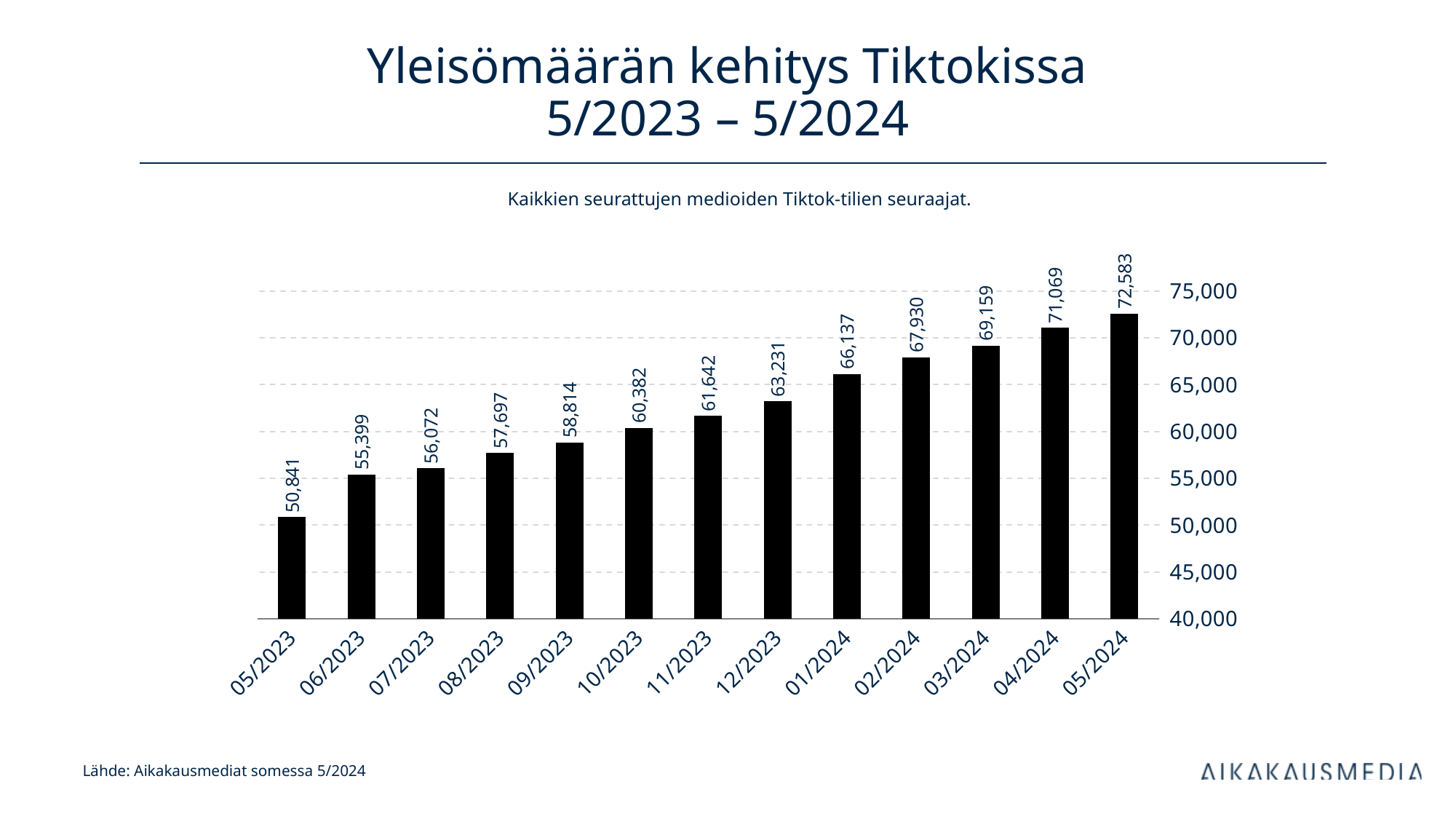
Do the values rise or fall from 05/2023 to 05/2024? rise What is the value for 05/2023? 50,841 Which is larger, the value for 09/2023 or the value for 10/2023? 10/2023 What kind of chart is shown on the slide? bar chart Is the value for 11/2023 greater or less than 60,000? greater How many months are shown on the x axis? 13 What is the difference between the values for 01/2024 and 12/2023? 2,906 What is the difference between the values for 05/2024 and 05/2023? 21,742 What is the value for 12/2023? 63,231 Which month has the highest value? 05/2024 What is the value for 03/2024? 69,159 Which month has the lowest value? 05/2023